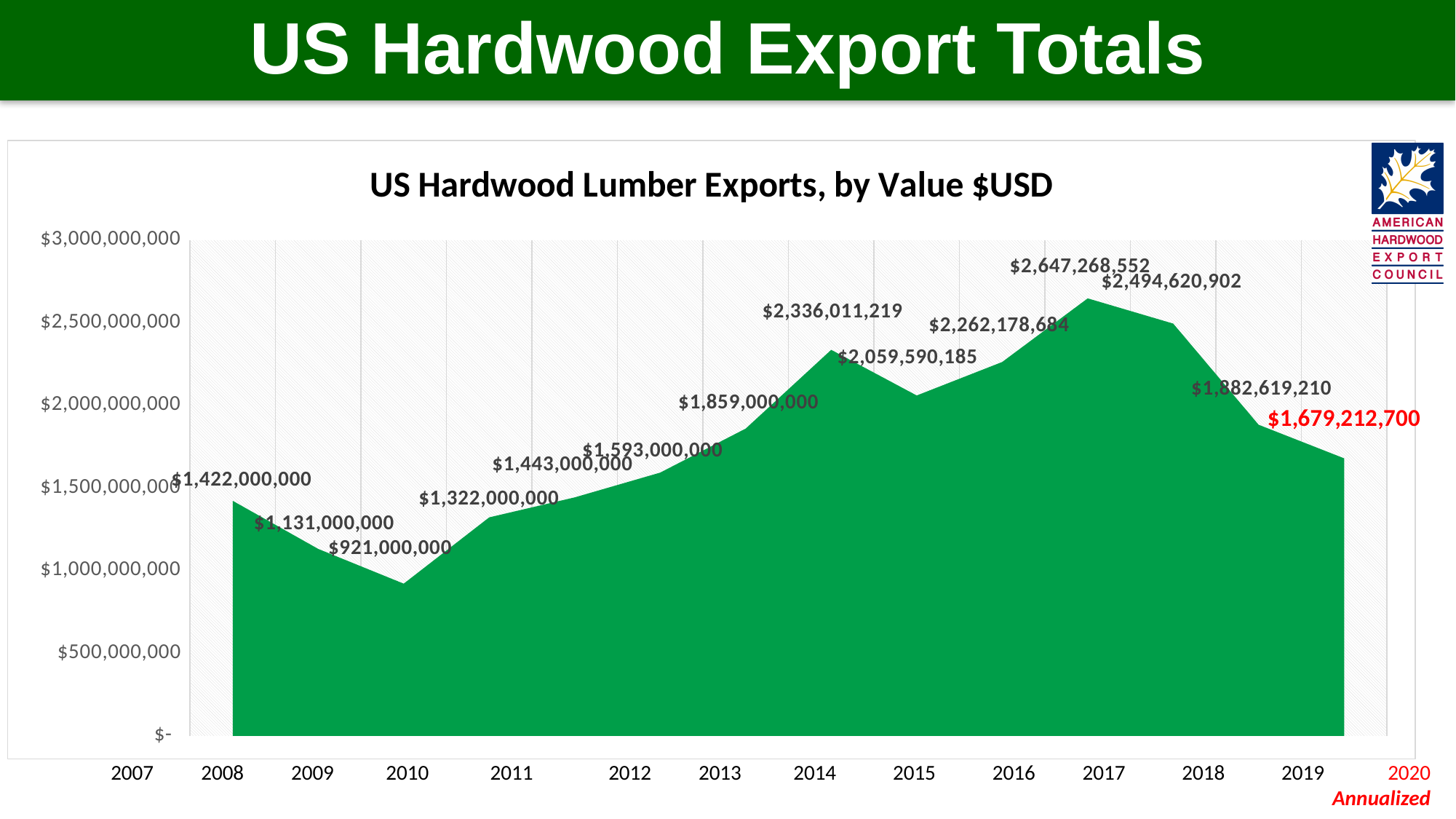
Do the export values rise or fall from the peak of $2,647,268,552 to the end of the series? fall What kind of chart is shown on the slide? Area chart What colour is the filled area in the chart? Green What is the difference between the highest labelled value ($2,647,268,552) and the lowest labelled value ($921,000,000)? $1,726,268,552 What is the title of the chart? US Hardwood Lumber Exports, by Value $USD What is the lowest export value labelled on the chart? $921,000,000 What is the difference between the peak value of $2,647,268,552 and the 2020 Annualized value of $1,679,212,700? $968,055,852 Is the 2020 Annualized value greater or less than $2,000,000,000? less How many years are labelled along the x axis of the chart? 14 What is the highest export value labelled on the chart? $2,647,268,552 Which is larger, the labelled value $2,336,011,219 or the labelled value $2,262,178,684? $2,336,011,219 What is the 2020 Annualized export value shown in red on the chart? $1,679,212,700